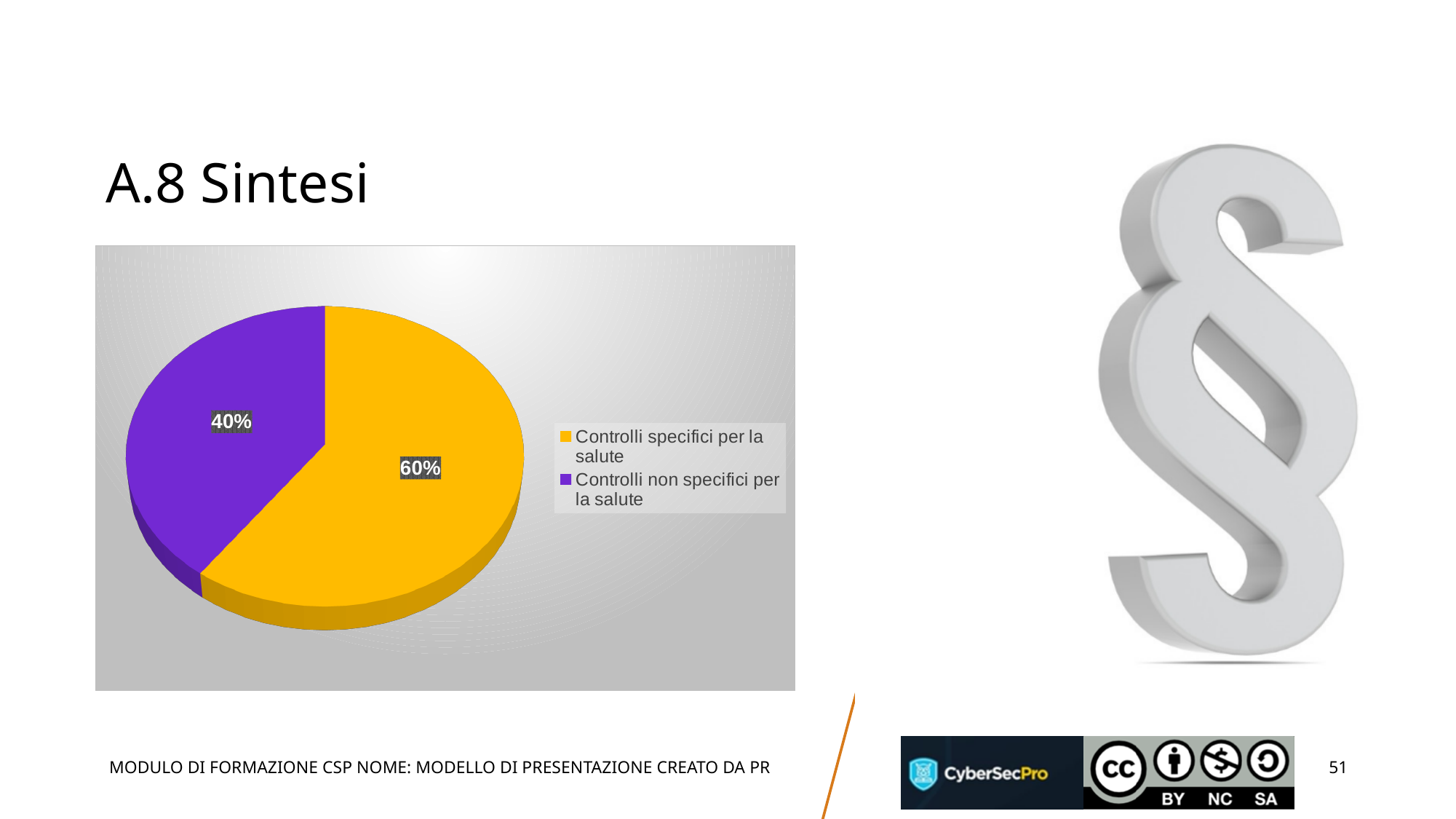
How many slices does the pie chart have? 2 What is the value for "Controlli specifici per la salute"? 60% What colour is the slice for "Controlli non specifici per la salute"? Purple Which is larger: "Controlli specifici per la salute" or "Controlli non specifici per la salute"? Controlli specifici per la salute What kind of chart is shown on the slide? Pie chart What colour is the slice for "Controlli specifici per la salute"? Yellow What is the value for "Controlli non specifici per la salute"? 40% How many entries does the legend list? 2 Which category has the smallest slice of the pie? Controlli non specifici per la salute Which category has the largest slice of the pie? Controlli specifici per la salute What is the difference between the share for "Controlli specifici per la salute" and "Controlli non specifici per la salute"? 20% What share of the pie does "Controlli non specifici per la salute" represent? 40%